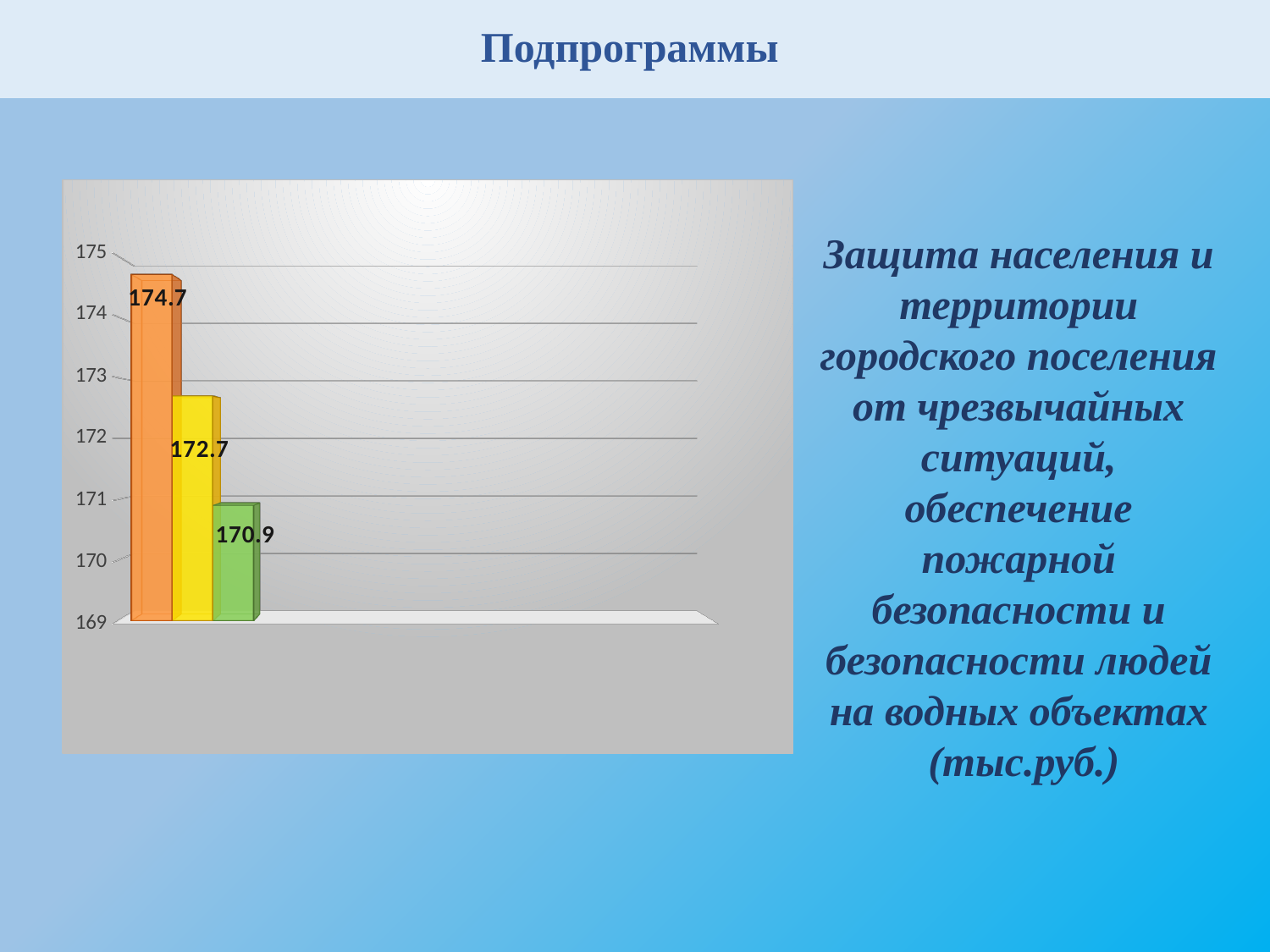
What value is shown on the green bar? 170.9 What kind of chart is shown on the slide? Bar chart What is the difference between the orange bar and the green bar? 3.8 How many bars are plotted in the chart? 3 What value is shown on the yellow bar? 172.7 What is the difference between the orange bar and the yellow bar? 2 Is the value of the green bar greater or less than 171? less Which bar has the highest value? The orange bar (174.7) Do the bar values rise or fall from left to right? Fall Which is larger, the yellow bar or the green bar? The yellow bar Which bar has the lowest value? The green bar (170.9) What value is shown on the orange bar? 174.7